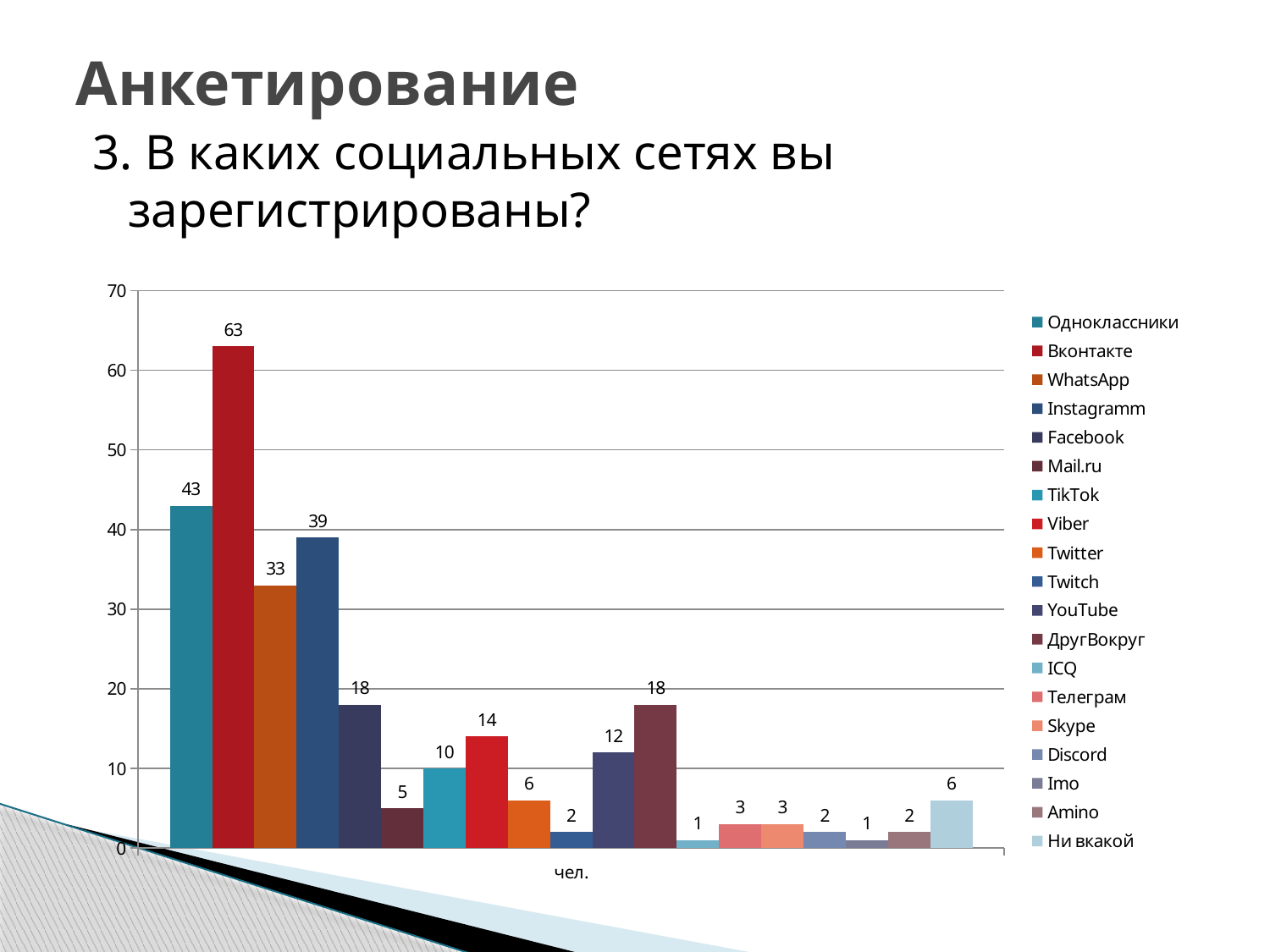
What is the difference between the values for Facebook and Mail.ru? 13 What is the value for TikTok? 10 What type of chart is shown on the slide? bar chart What is the difference between the values for Вконтакте and Одноклассники? 20 What is the value for Вконтакте? 63 Which is larger, the value for WhatsApp or the value for Instagramm? Instagramm What is the value for Одноклассники? 43 What is the value for Ни вкакой? 6 How many entries does the legend list? 19 Which social network has the highest value? Вконтакте What label is shown on the horizontal axis of the chart? чел. What is the value for Instagramm? 39